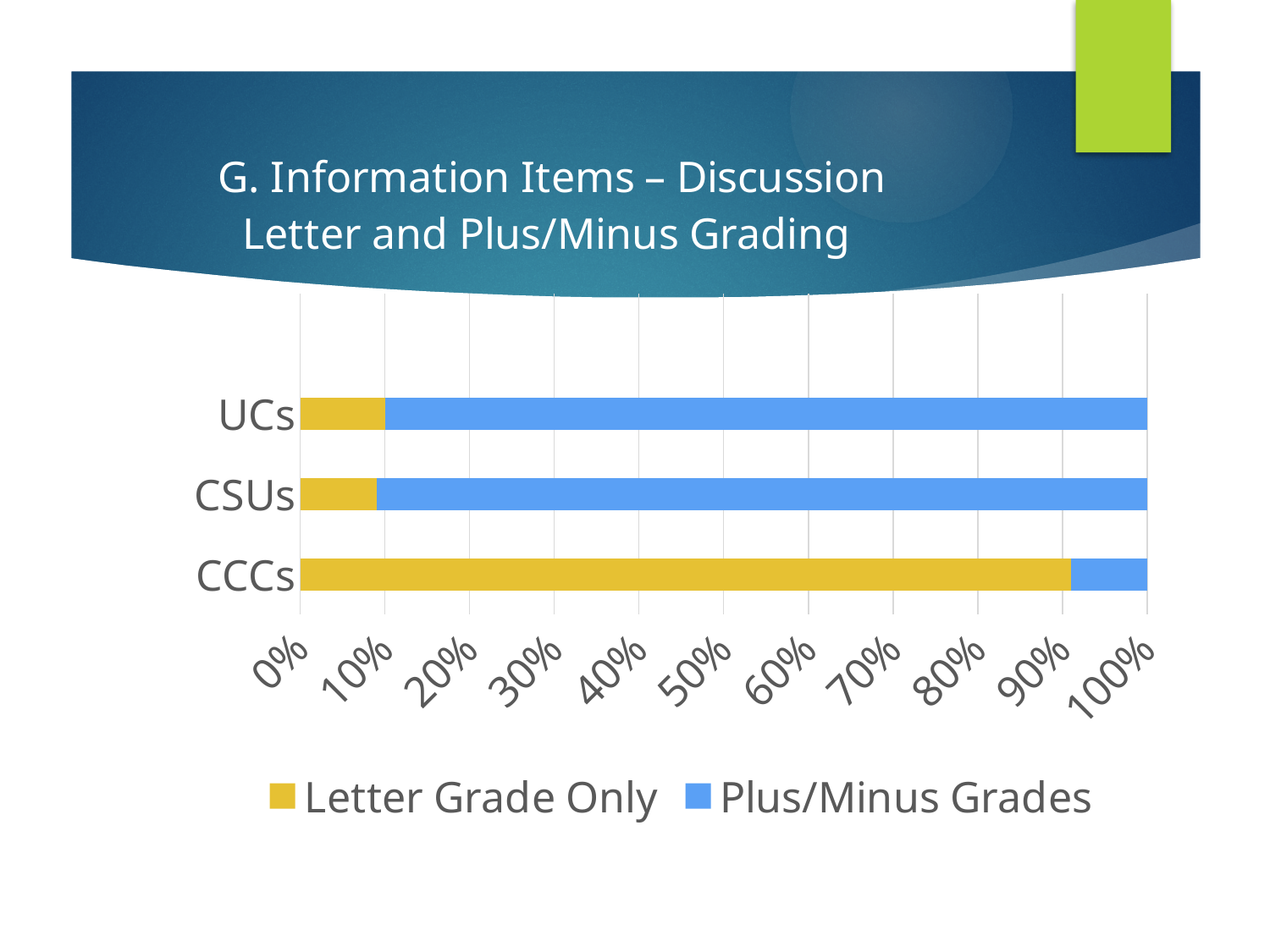
Which colour represents the Letter Grade Only series? Yellow Which has a larger Letter Grade Only share, CCCs or UCs? CCCs Is the Plus/Minus Grades value for CCCs greater or less than 20%? less Which category has the lowest Plus/Minus Grades share? CCCs Is the Letter Grade Only value for CCCs greater or less than 80%? greater Which category has the highest Letter Grade Only share? CCCs What kind of chart is shown on the slide? Stacked bar chart Is the Plus/Minus Grades value for CSUs greater or less than 80%? greater Which has a larger Plus/Minus Grades share, CSUs or CCCs? CSUs How many categories are shown on the chart? 3 How many series does the legend list? 2